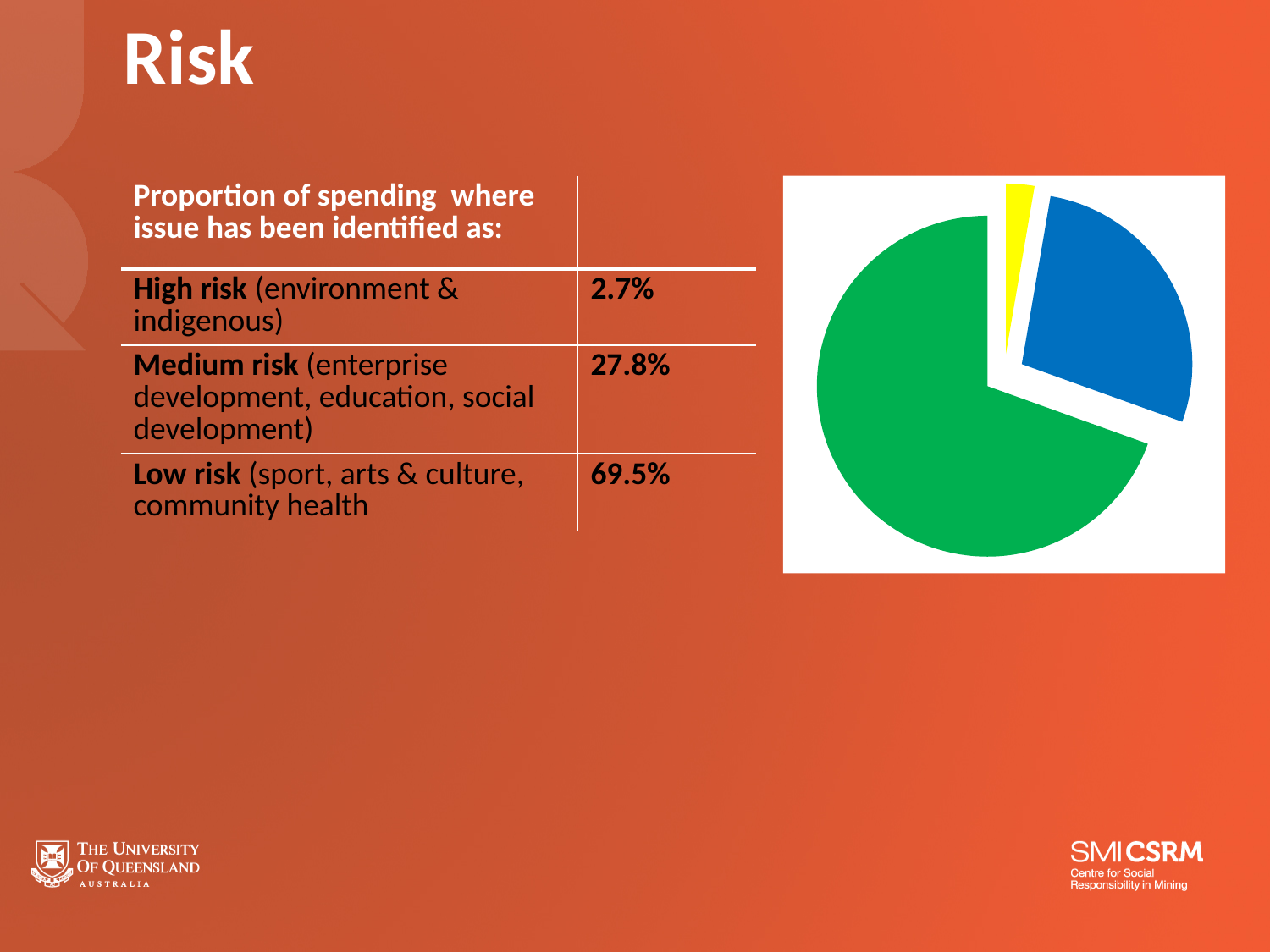
What proportion of spending is identified as medium risk? 27.8% Is the green slice larger or smaller than the blue slice? larger Does the pie chart display a legend? No What proportion of spending is identified as high risk? 2.7% Which risk category accounts for the largest share of spending? Low risk Which colour slice is the smallest in the pie chart? yellow What is the difference between the low risk and medium risk proportions of spending? 41.7% What proportion of spending is identified as low risk? 69.5% How many slices does the pie chart have? 3 What kind of chart is shown on the slide? pie chart Which risk category accounts for the smallest share of spending? High risk Which colour slice is the largest in the pie chart? green